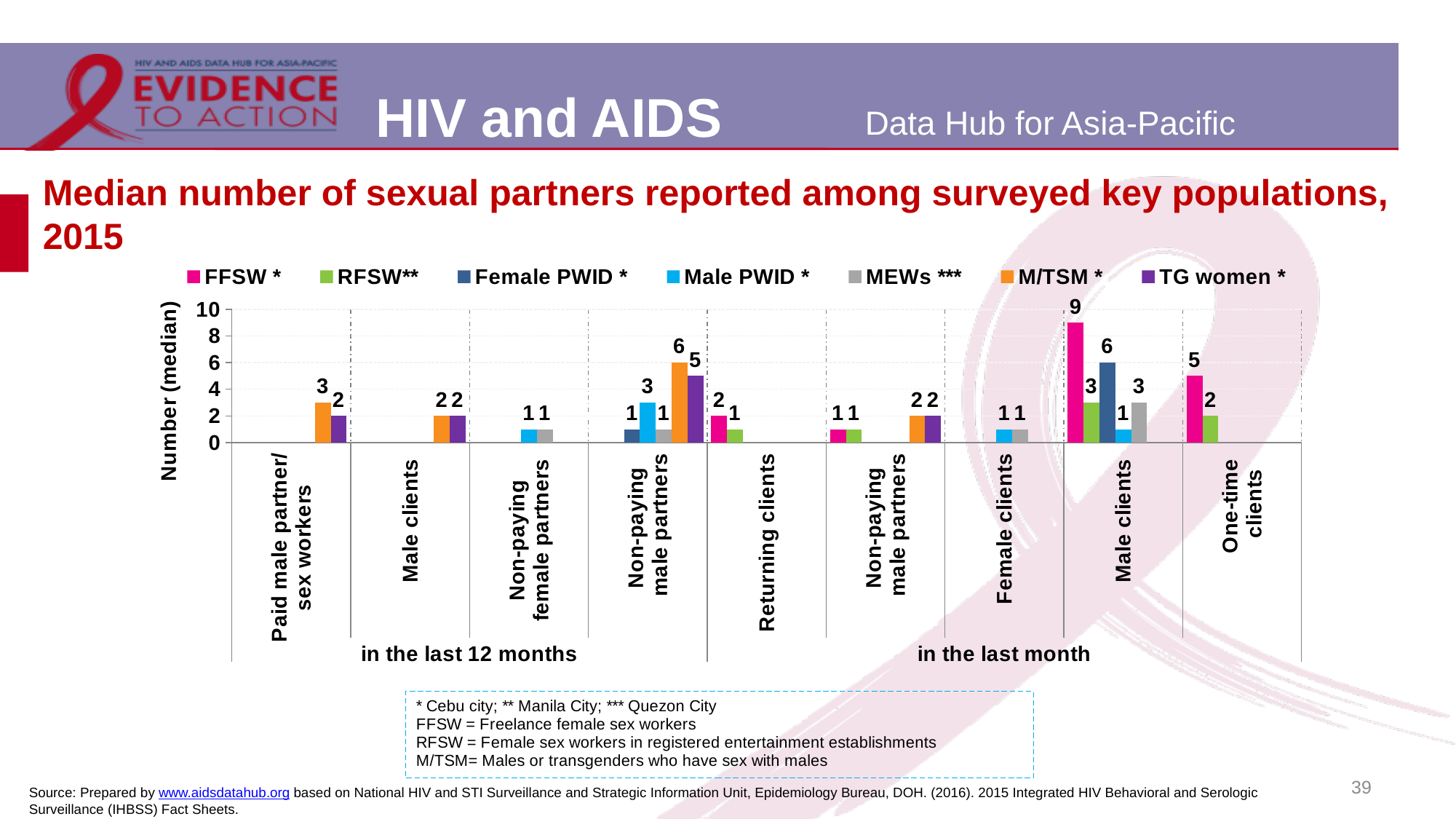
For non-paying male partners in the last 12 months, which is larger: the M/TSM value or the TG women value? M/TSM What kind of chart is shown on the slide? Bar chart Which series has the highest value anywhere on the chart? FFSW (male clients in the last month) What is the title of the vertical axis? Number (median) What is the median number of paid male partners/sex workers in the last 12 months reported by TG women? 2 How many series does the legend list? 7 For one-time clients in the last month, how much higher is the FFSW value than the RFSW value? 3 How many partner-type categories are shown along the x axis? 9 What is the median number of male clients in the last month reported by FFSW? 9 What is the median number of non-paying male partners in the last 12 months reported by M/TSM? 6 What is the median number of non-paying male partners in the last 12 months reported by Male PWID? 3 What is the median number of male clients in the last month reported by Female PWID? 6